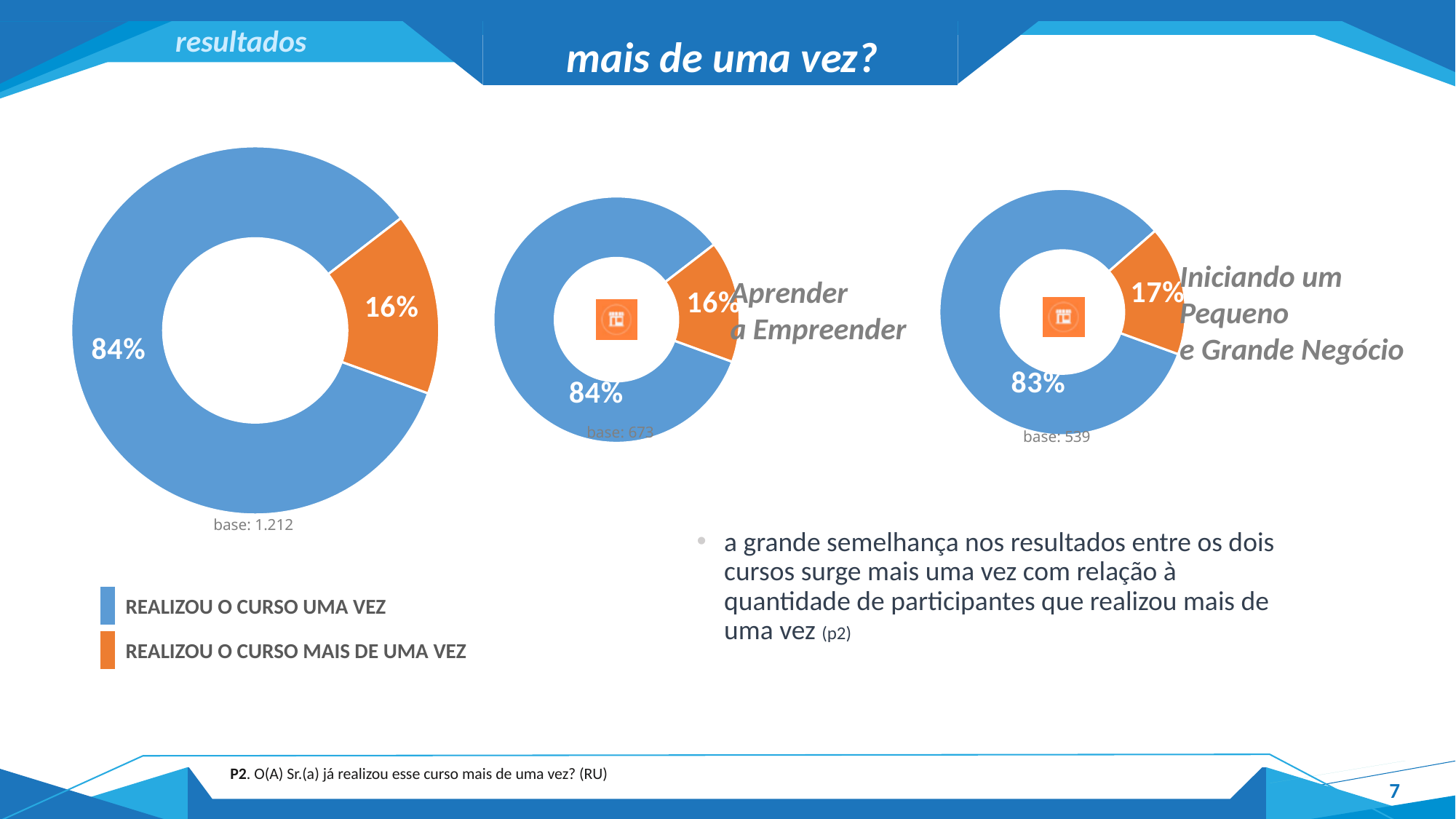
How many donut charts are shown on the slide? 3 What is the difference in percentage points between the 'uma vez' shares of Aprender a Empreender (84%) and Iniciando um Pequeno e Grande Negócio (83%)? 1 percentage point Which course has the larger share of participants who realizou o curso mais de uma vez: Aprender a Empreender or Iniciando um Pequeno e Grande Negócio? Iniciando um Pequeno e Grande Negócio What type of chart is used on this slide? Donut (pie) chart How many categories does the legend list? 2 What is the base (number of respondents) for the large donut chart on the left? 1.212 In the Iniciando um Pequeno e Grande Negócio donut chart, what share of participants realizou o curso uma vez? 83% Which colour represents 'REALIZOU O CURSO MAIS DE UMA VEZ' in the charts? Orange In the Aprender a Empreender donut chart, what share of participants realizou o curso mais de uma vez? 16% In the large donut chart on the left, what percentage of participants realizou o curso uma vez? 84% In the Iniciando um Pequeno e Grande Negócio donut chart, what percentage realizou o curso mais de uma vez? 17% In the large donut chart on the left, what percentage of participants realizou o curso mais de uma vez? 16%